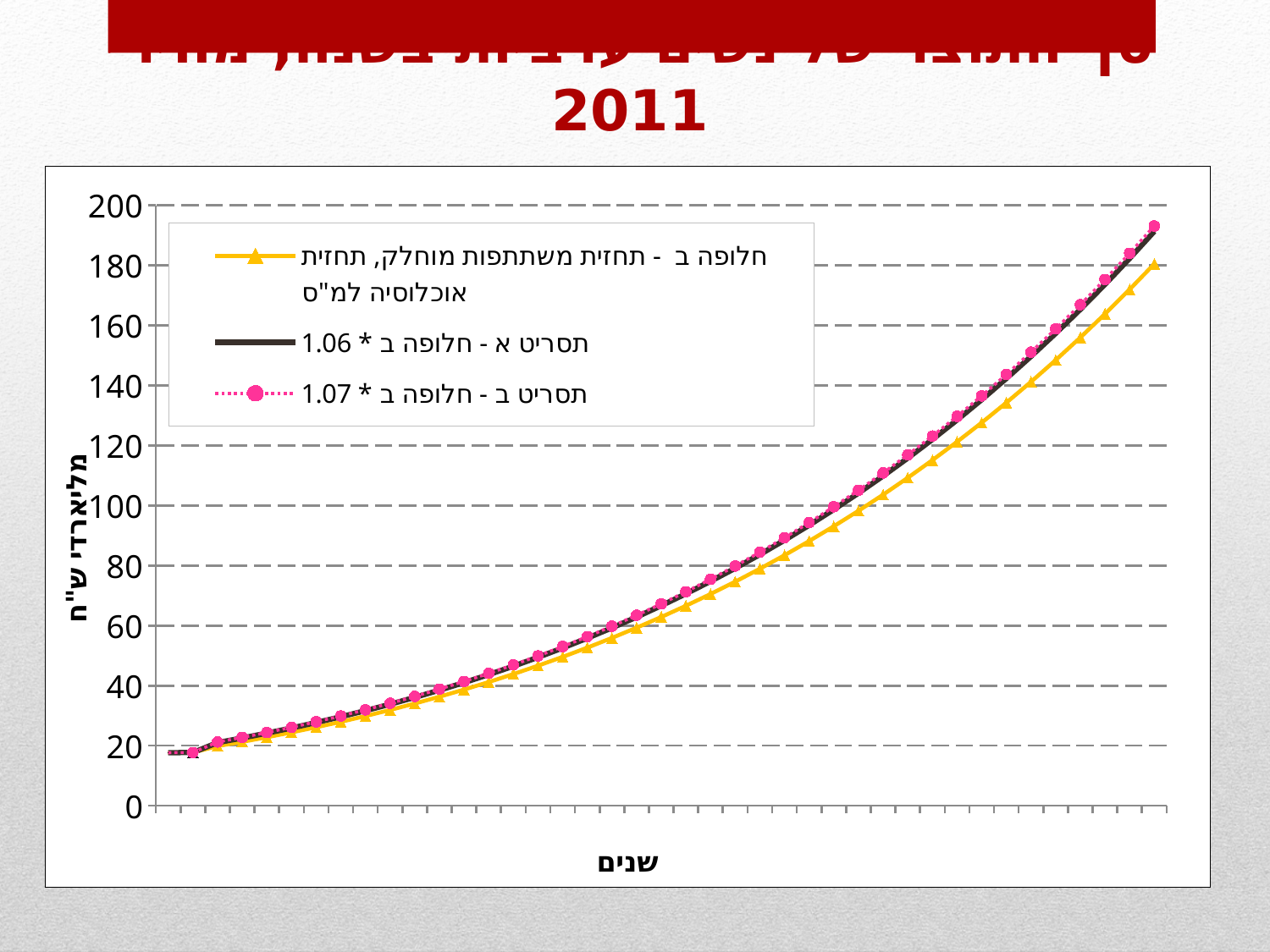
Is the first value of the series "תסריט א - חלופה ב * 1.06" greater or less than 40? less At the right end of the chart, which series is higher: "תסריט ב - חלופה ב * 1.07" or "חלופה ב - תחזית משתתפות מוחלק, תחזית אוכלוסיה למ"ס"? תסריט ב - חלופה ב * 1.07 What kind of chart is shown on the slide? line chart Is the final value of the series "חלופה ב - תחזית משתתפות מוחלק, תחזית אוכלוסיה למ"ס" greater or less than 200? less Is the final value of the series "תסריט ב - חלופה ב * 1.07" greater or less than 180? greater Do the values of the series rise or fall along the x axis? rise Which series has the lowest value at the right end of the chart? חלופה ב - תחזית משתתפות מוחלק, תחזית אוכלוסיה למ"ס How many series does the legend list? 3 What is the label of the x axis? שנים What is the label of the y axis? מליארדי ש"ח